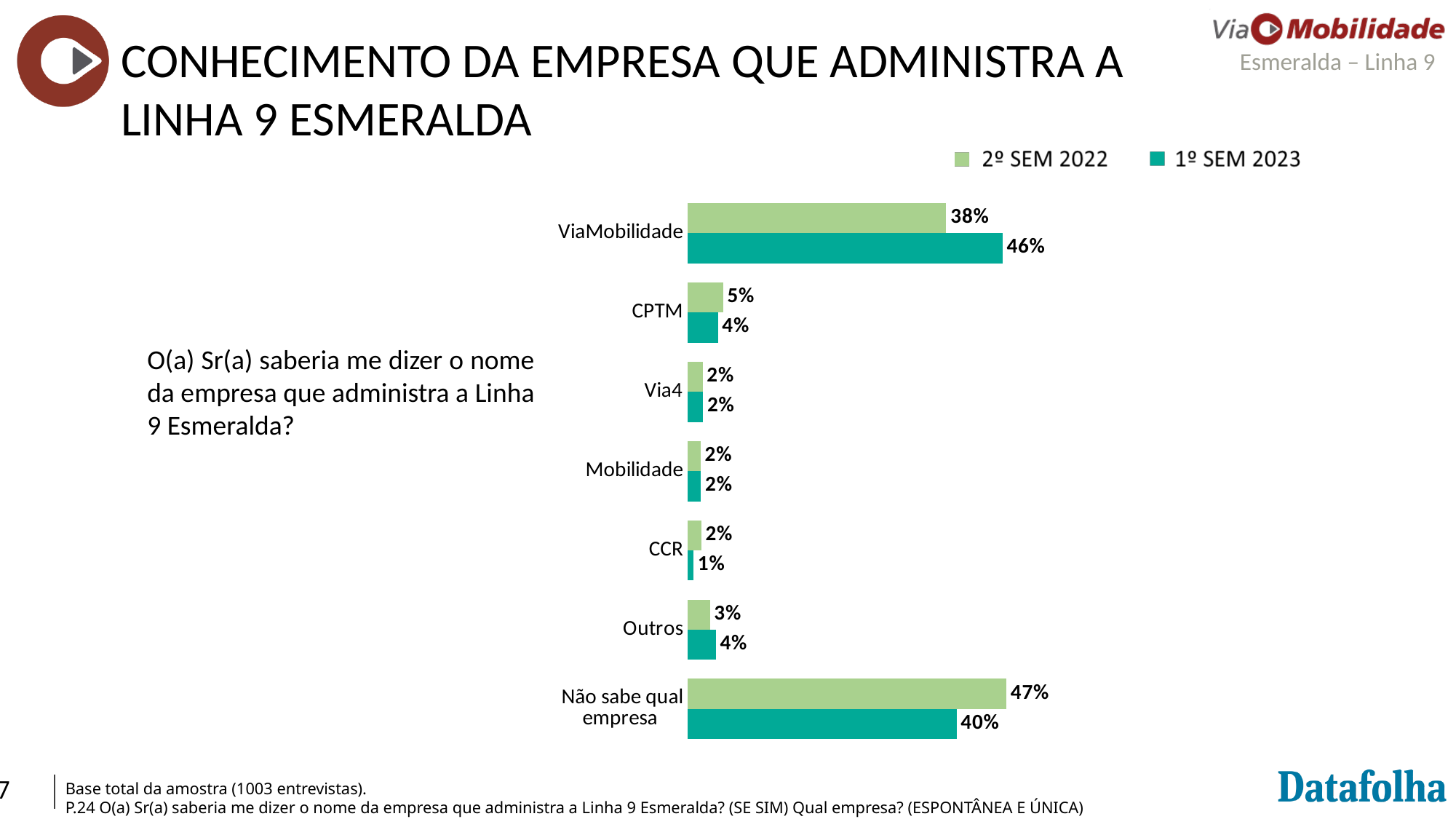
What is the value for CPTM in the 2º SEM 2022 series? 5% Which category has the lowest value in the 1º SEM 2023 series? CCR Which series is shown in the darker teal colour? 1º SEM 2023 What is the difference between the 1º SEM 2023 and 2º SEM 2022 values for ViaMobilidade? 8 percentage points What kind of chart is shown on the slide? Bar chart What is the value for CCR in the 1º SEM 2023 series? 1% Which is larger for Outros: the 2º SEM 2022 value or the 1º SEM 2023 value? 1º SEM 2023 What is the value for Não sabe qual empresa in the 2º SEM 2022 series? 47% Which category has the highest value in the 1º SEM 2023 series? ViaMobilidade What is the value for ViaMobilidade in the 1º SEM 2023 series? 46% How many series does the legend list? 2 How many categories are shown on the chart? 7